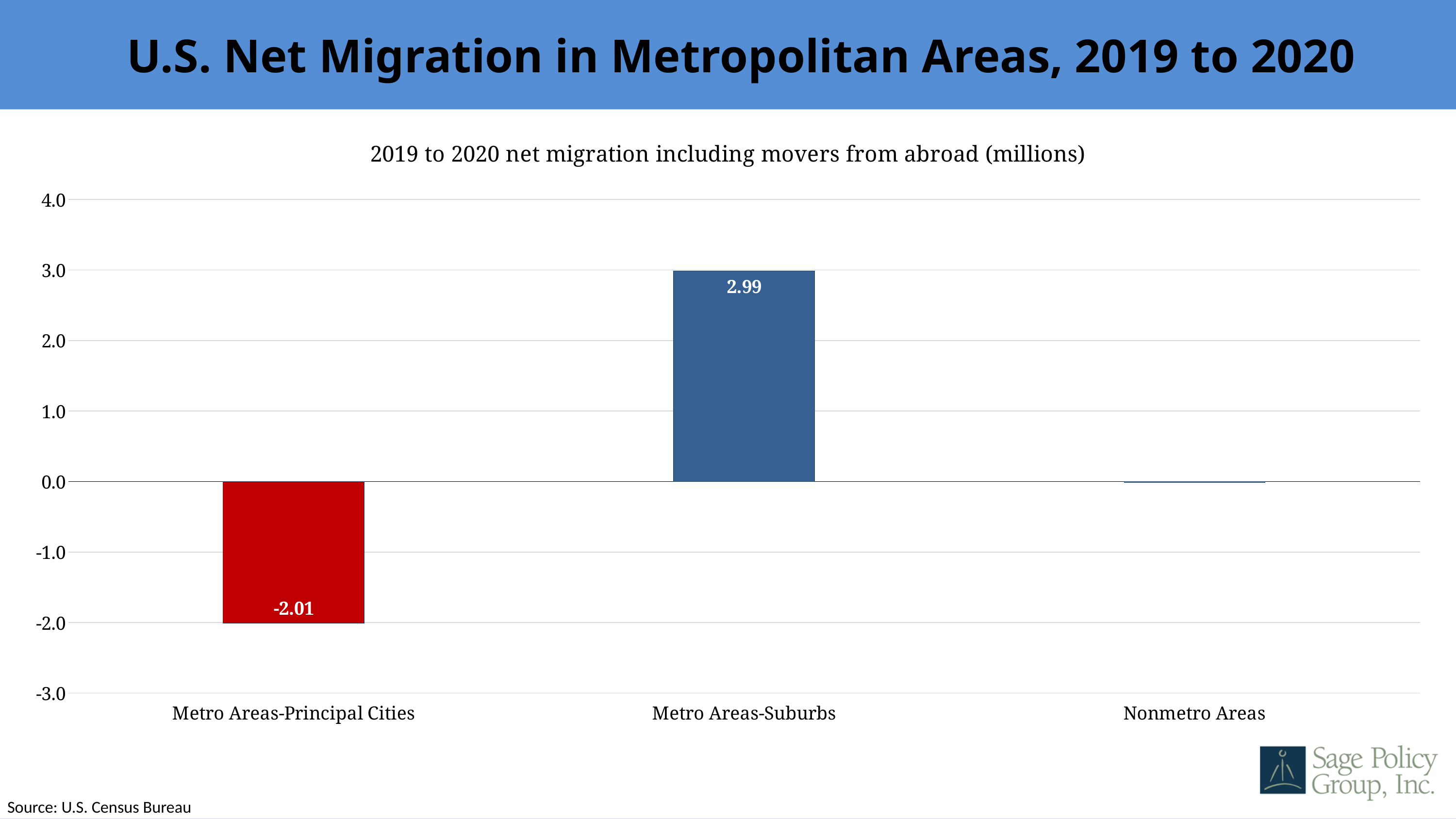
What is the title of the chart? 2019 to 2020 net migration including movers from abroad (millions) Which category has the lowest value? Metro Areas-Principal Cities Which category has the highest value? Metro Areas-Suburbs What is the value for Metro Areas-Principal Cities? -2.01 What is the difference between the values for Metro Areas-Suburbs and Metro Areas-Principal Cities? 5.00 What colour is the bar for Metro Areas-Principal Cities? red Is the value for Metro Areas-Principal Cities greater or less than -1.0? less Which is larger, the value for Metro Areas-Suburbs or the value for Nonmetro Areas? Metro Areas-Suburbs What is the value for Metro Areas-Suburbs? 2.99 Is the value for Metro Areas-Suburbs greater or less than 2.0? greater What kind of chart is shown on the slide? bar chart How many categories are shown on the x axis? 3